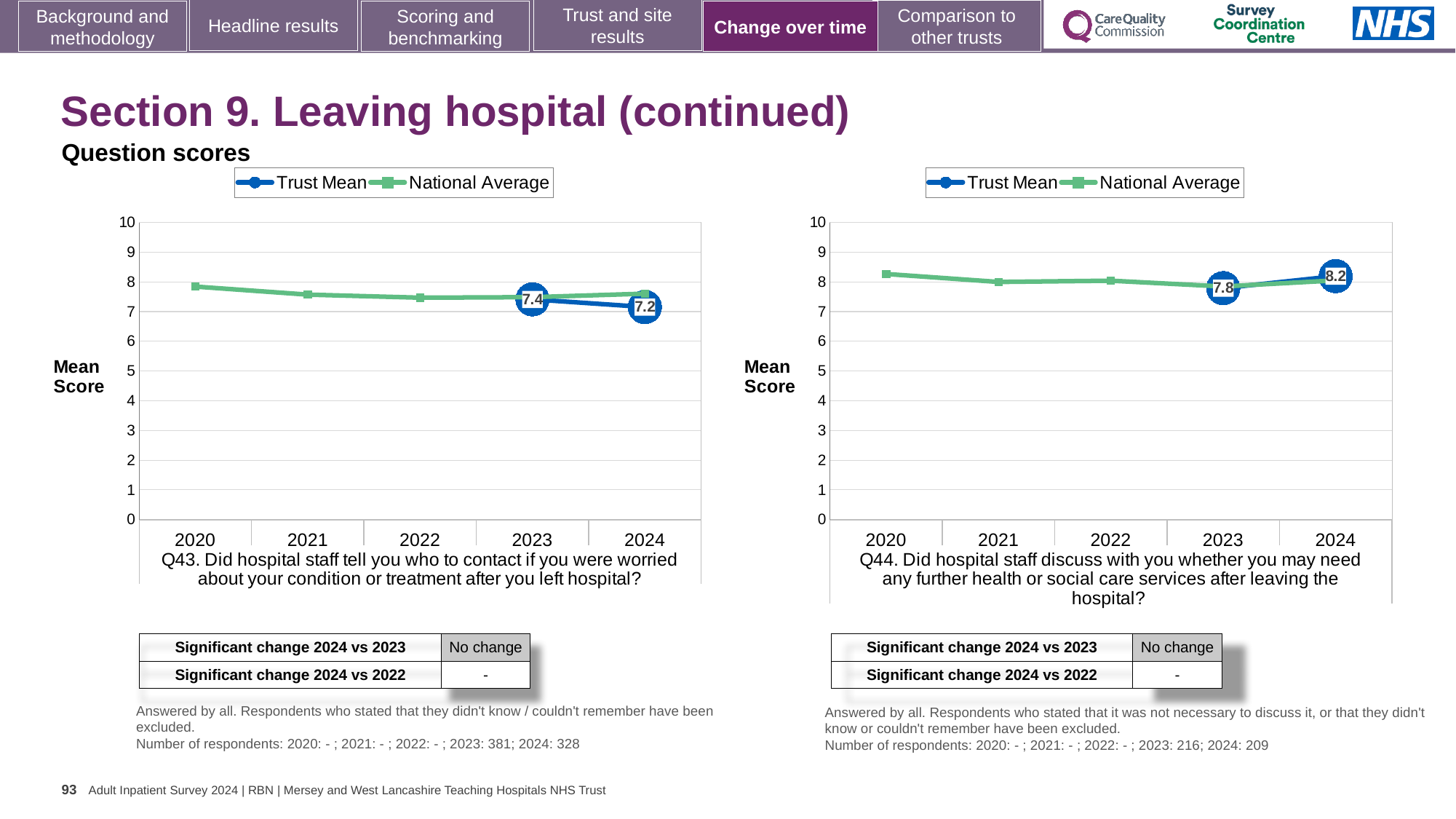
On the Q44 chart (right), what is the Trust Mean score for 2024? 8.2 On the Q44 chart (right), what is the Trust Mean score for 2023? 7.8 On the Q44 chart (right), by how much did the Trust Mean score change from 2023 to 2024? 0.4 On the Q43 chart (left), is the National Average for 2020 greater or less than 7? greater On the Q44 chart (right), did the Trust Mean rise or fall from 2023 to 2024? rise How many series does the legend list on the Q44 chart (right)? 2 On the Q43 chart (left), what is the difference between the Trust Mean scores for 2023 and 2024? 0.2 On the Q43 chart (left), did the Trust Mean rise or fall from 2023 to 2024? fall How many years are shown on the x axis of the Q43 chart (left)? 5 On the Q43 chart (left), what is the Trust Mean score for 2024? 7.2 On the Q44 chart (right), is the National Average for 2020 greater or less than 9? less On the Q43 chart (left), what is the Trust Mean score for 2023? 7.4